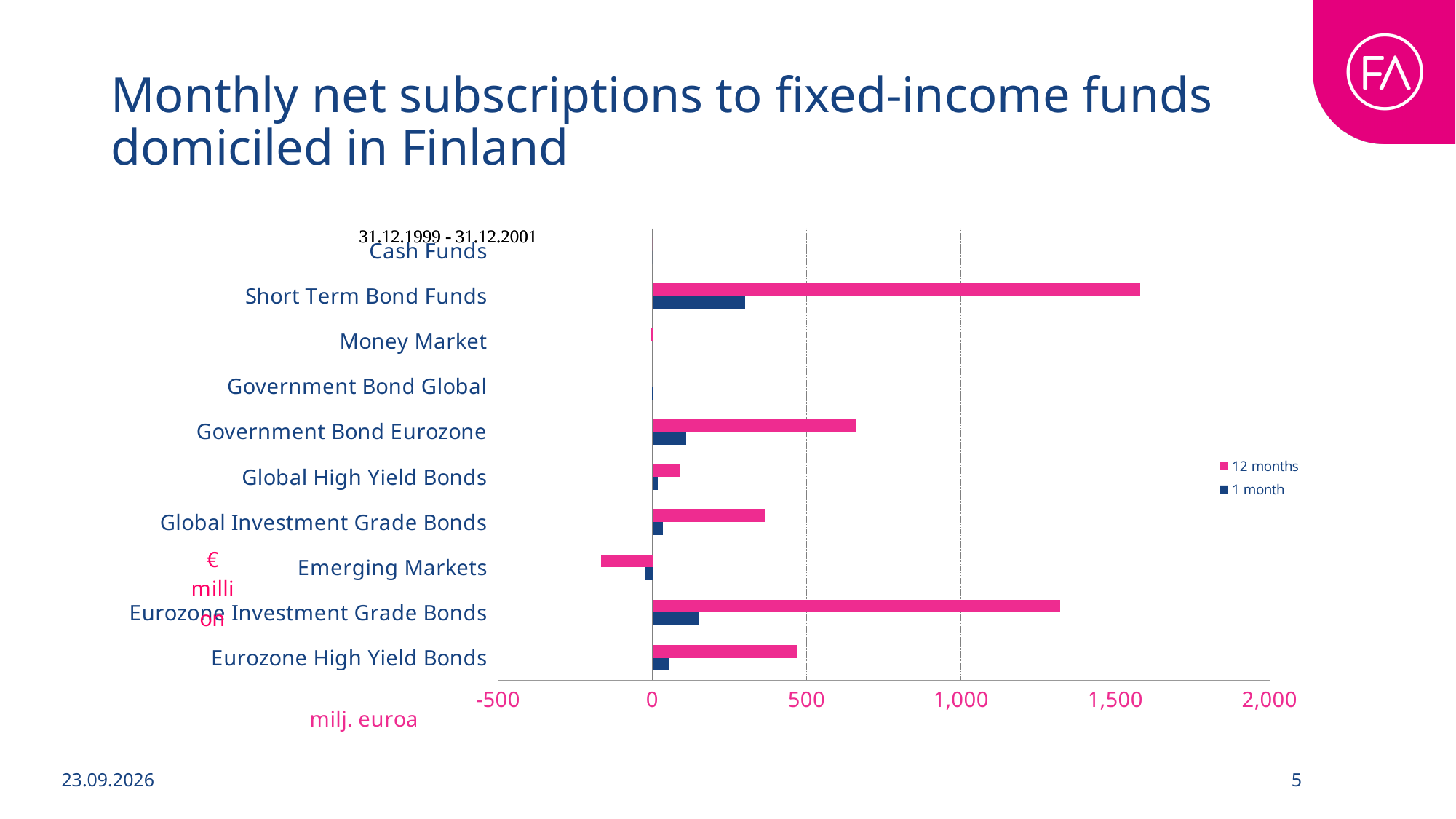
Is the 12 months value for Emerging Markets greater or less than 0? less What kind of chart is shown on the slide? bar chart Which is larger, the 12 months value for Eurozone Investment Grade Bonds or for Government Bond Eurozone? Eurozone Investment Grade Bonds What are the two series named in the legend? 12 months and 1 month Is the 12 months value for Eurozone Investment Grade Bonds greater or less than 1,000? greater How many series does the legend list? 2 Which category has the highest 1 month value? Short Term Bond Funds How many fund categories are listed on the vertical axis? 10 Which category has the highest 12 months value? Short Term Bond Funds Is the 12 months value for Government Bond Eurozone greater or less than 500? greater Which category has the lowest 12 months value? Emerging Markets